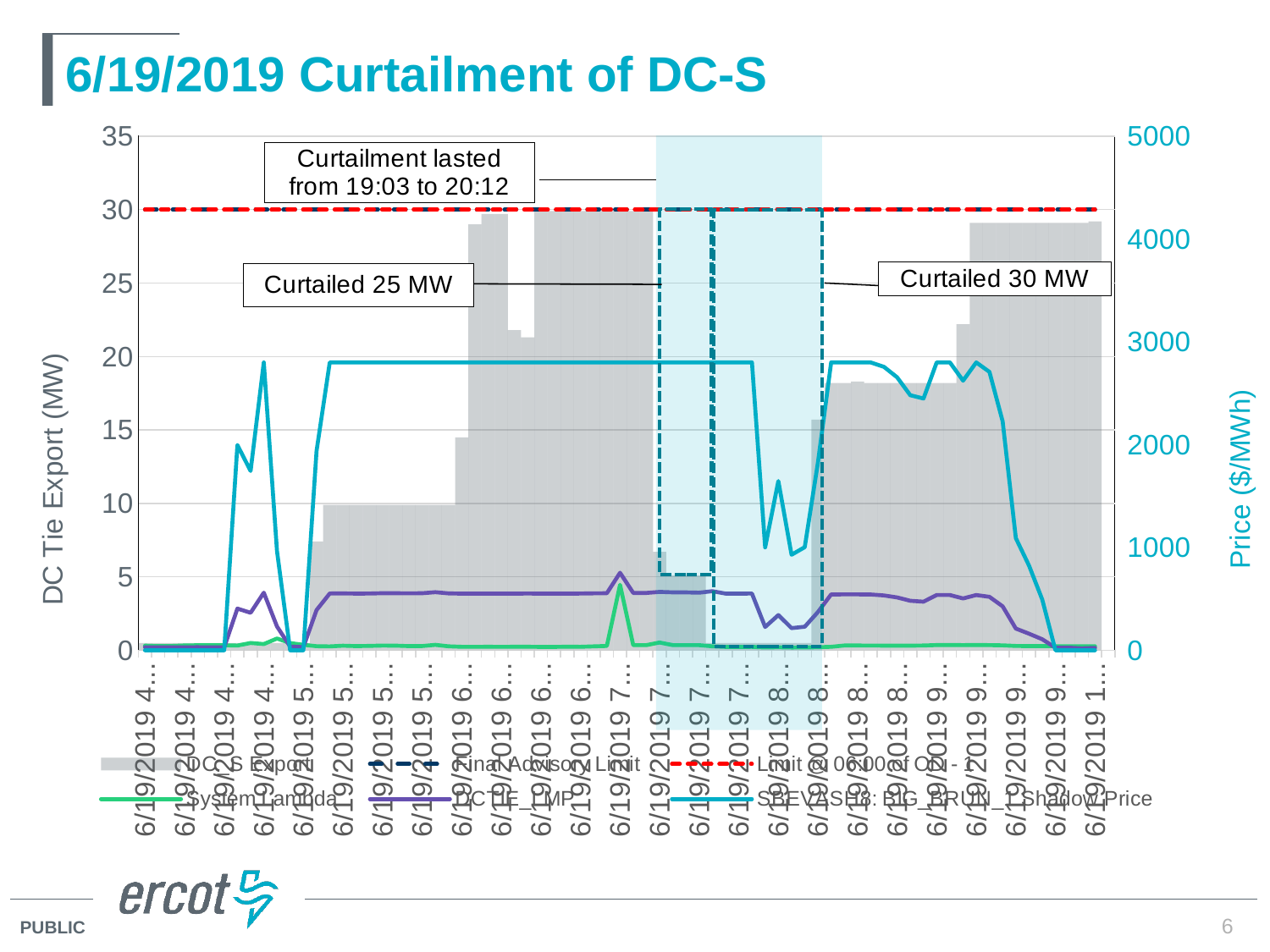
How many MW were curtailed in the first curtailment step, according to the annotation? 25 MW At what value on the left axis does the 'Limit @ 06:00 of OD - 1' line sit? 30 What is the label of the left vertical axis? DC Tie Export (MW) Is the DC TIE_LMP line ever greater than 1000 $/MWh on the right axis? No, it stays less than 1000 What is the label of the right vertical axis? Price ($/MWh) According to the annotation, from what time to what time did the curtailment last? from 19:03 to 20:12 Does the SBEVASH8: BIG_BRUN_1 Shadow Price rise or fall over the last portion of the x axis (from 6/19/2019 9... to the end)? fall What kind of chart is shown on the slide? Combination chart of a shaded area (bars) and lines How many MW were curtailed in the second curtailment step, according to the annotation? 30 MW Is the peak of the SBEVASH8: BIG_BRUN_1 Shadow Price greater or less than 3000 $/MWh? less How many series does the chart legend list? 6